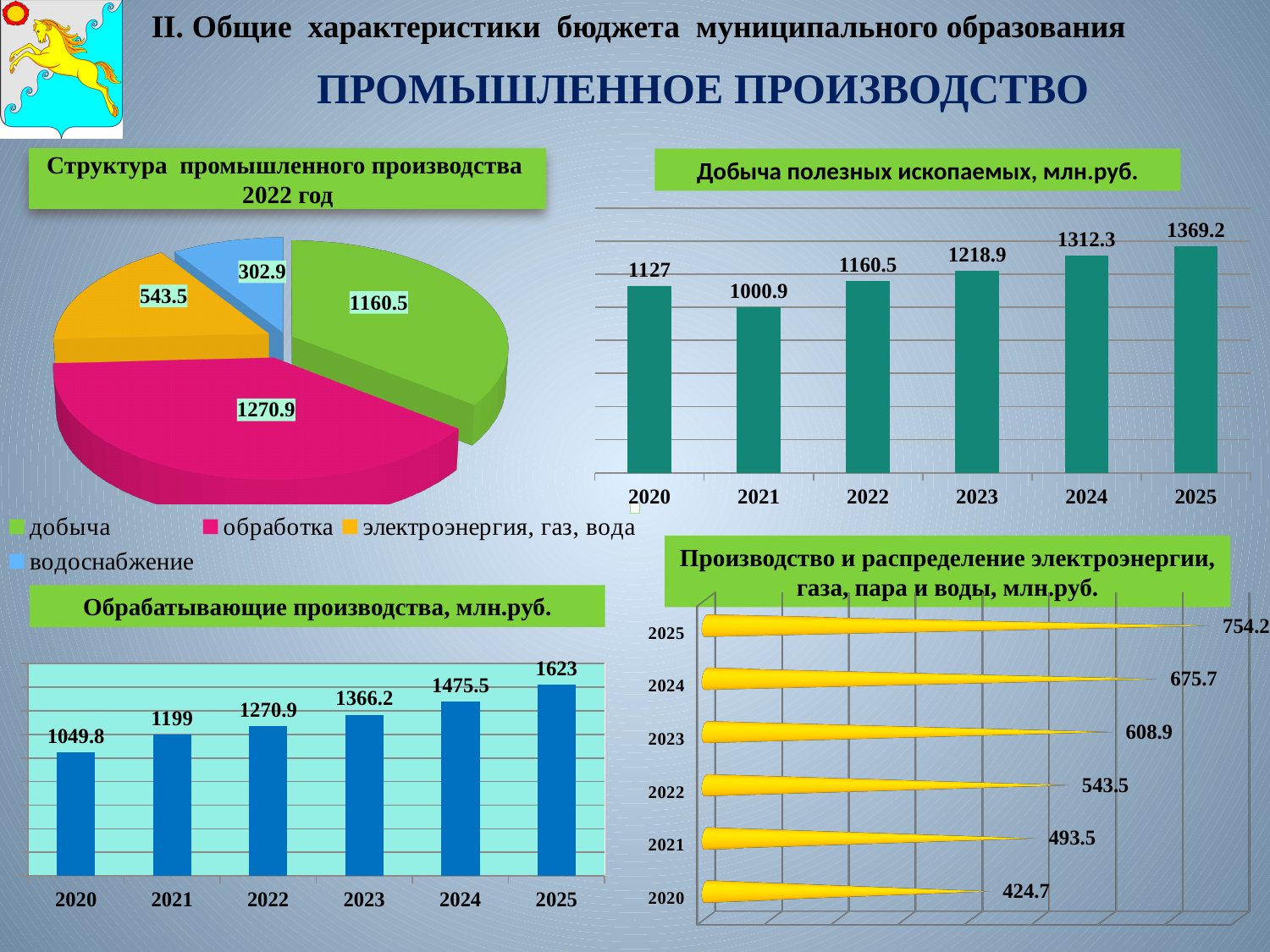
In the chart 'Обрабатывающие производства, млн.руб.', how many years are plotted? 6 Which is larger: the 2022 value in 'Добыча полезных ископаемых, млн.руб.' or the 2022 value in 'Обрабатывающие производства, млн.руб.'? Обрабатывающие производства (1270.9) In the pie chart 'Структура промышленного производства 2022 год', which category has the smallest slice? водоснабжение In the chart 'Обрабатывающие производства, млн.руб.', do the values rise or fall from 2020 to 2025? rise In the pie chart 'Структура промышленного производства 2022 год', what is the value for обработка? 1270.9 In the chart 'Добыча полезных ископаемых, млн.руб.', what is the difference between the 2025 and 2020 values? 242.2 In the chart 'Добыча полезных ископаемых, млн.руб.', what is the value for 2023? 1218.9 In the pie chart 'Структура промышленного производства 2022 год', how many categories does the legend list? 4 In the chart 'Обрабатывающие производства, млн.руб.', what is the value for 2024? 1475.5 In the chart 'Производство и распределение электроэнергии, газа, пара и воды, млн.руб.', what is the value for 2021? 493.5 In the chart 'Производство и распределение электроэнергии, газа, пара и воды, млн.руб.', what is the difference between the 2025 and 2024 values? 78.5 In the chart 'Добыча полезных ископаемых, млн.руб.', which year has the lowest value? 2021